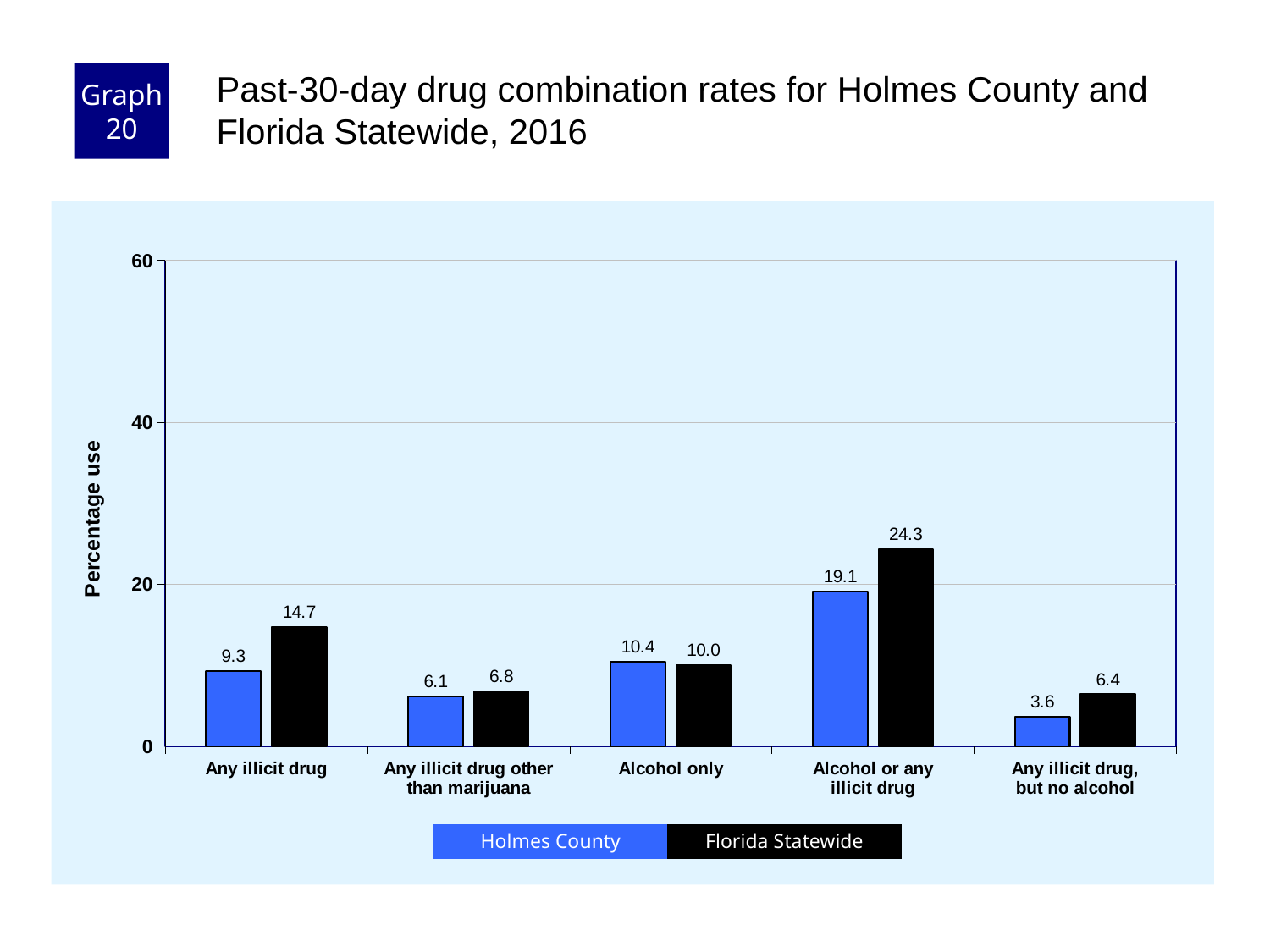
How many series does the legend list? 2 Which is larger for Alcohol only: Holmes County or Florida Statewide? Holmes County What kind of chart is shown on the slide? Bar chart What is the label of the y axis? Percentage use Which category has the highest Florida Statewide value? Alcohol or any illicit drug Which category has the lowest Holmes County value? Any illicit drug, but no alcohol What is the Florida Statewide value for Alcohol or any illicit drug? 24.3 How many categories are shown on the x axis? 5 Is the Florida Statewide value for Alcohol or any illicit drug greater or less than 20? greater What is the difference between the Florida Statewide and Holmes County values for Any illicit drug? 5.4 What is the Holmes County value for Any illicit drug? 9.3 What is the Holmes County value for Any illicit drug, but no alcohol? 3.6